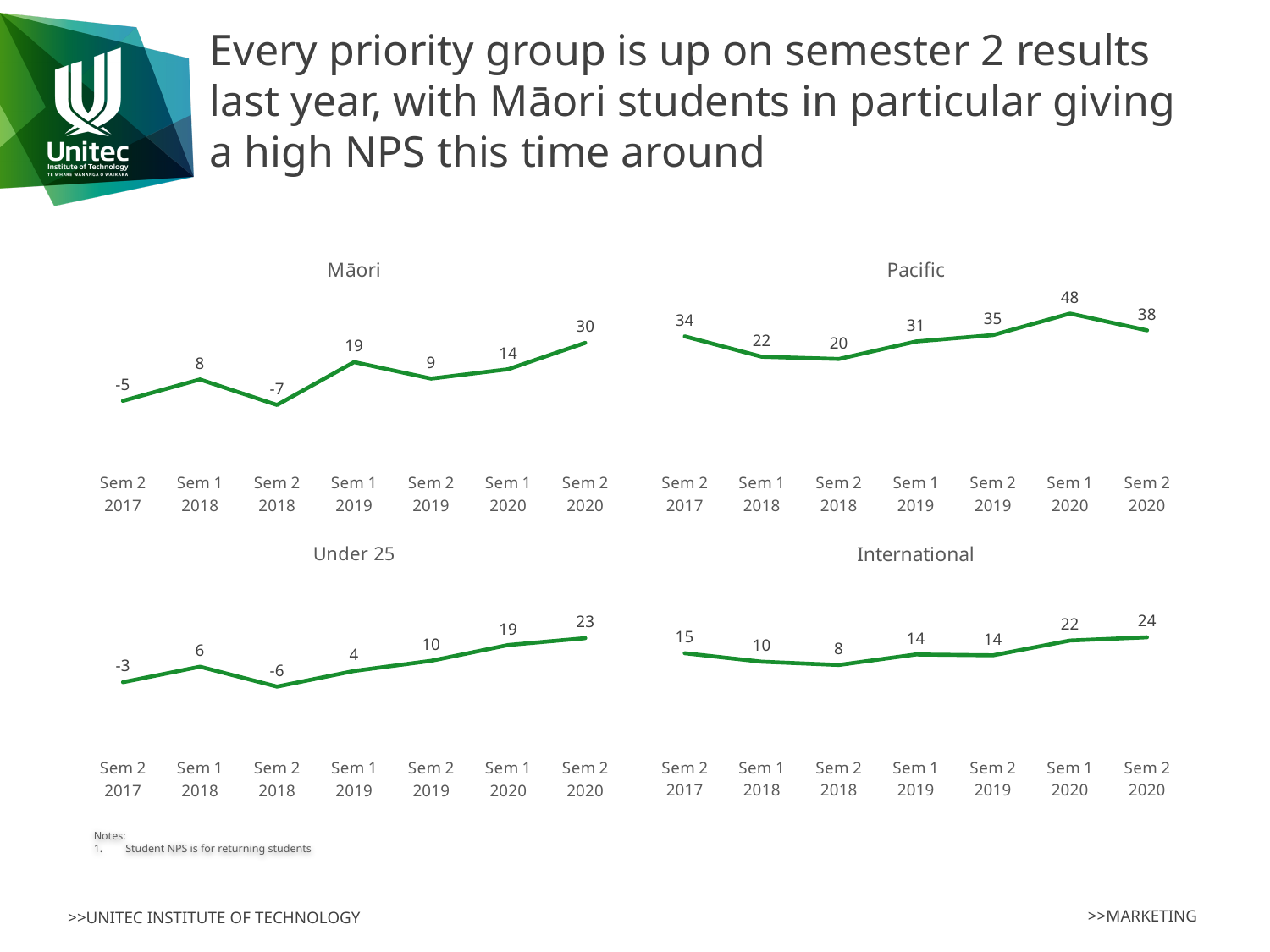
In the Pacific chart, which period has the highest value? Sem 1 2020 In the Under 25 chart, what is the value for Sem 1 2019? 4 What kind of chart is the Under 25 chart? Line chart How many data points are plotted in the Pacific chart? 7 How many charts are shown on the slide? 4 In the International chart, which is larger: the value for Sem 2 2017 or the value for Sem 2 2018? Sem 2 2017 In the International chart, do the values generally rise or fall from Sem 2 2018 to Sem 2 2020? Rise In the Māori chart, which period has the lowest value? Sem 2 2018 In the Under 25 chart, what is the difference between the Sem 2 2020 value and the Sem 2 2017 value? 26 In the Pacific chart, what is the difference between the Sem 1 2020 value and the Sem 2 2020 value? 10 In the Māori chart, what is the value for Sem 2 2020? 30 In the Pacific chart, what is the value for Sem 2 2018? 20